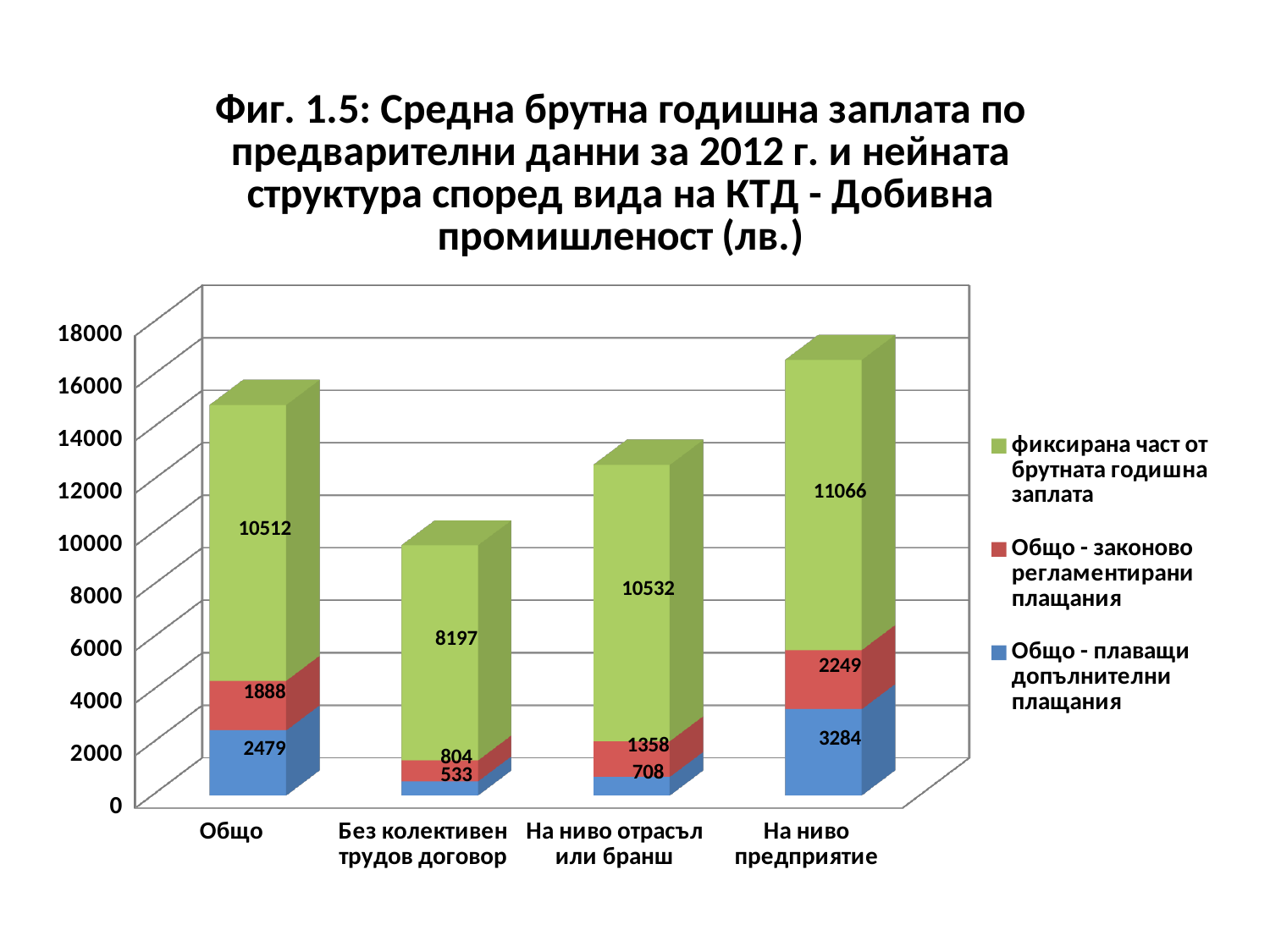
How many series does the legend list? 3 Which category has the highest value for 'Общо - плаващи допълнителни плащания'? На ниво предприятие What is the difference between the 'Общо - законово регламентирани плащания' values for 'На ниво предприятие' and 'На ниво отрасъл или бранш'? 891 What kind of chart is shown on the slide? Stacked bar chart What is the value of the fixed part of gross annual salary (фиксирана част от брутната годишна заплата) for 'На ниво предприятие'? 11066 Which is larger: the fixed part of gross annual salary for 'Общо' or for 'На ниво отрасъл или бранш'? На ниво отрасъл или бранш What is the value of 'Общо - законово регламентирани плащания' for 'Без колективен трудов договор'? 804 How many categories are shown on the x axis? 4 What is the total of the stacked bar for 'Без колективен трудов договор'? 9534 What is the value of 'Общо - плаващи допълнителни плащания' for the 'Общо' category? 2479 What is the total of the stacked bar for 'На ниво предприятие'? 16599 Which category has the lowest value for the fixed part of gross annual salary (фиксирана част от брутната годишна заплата)? Без колективен трудов договор